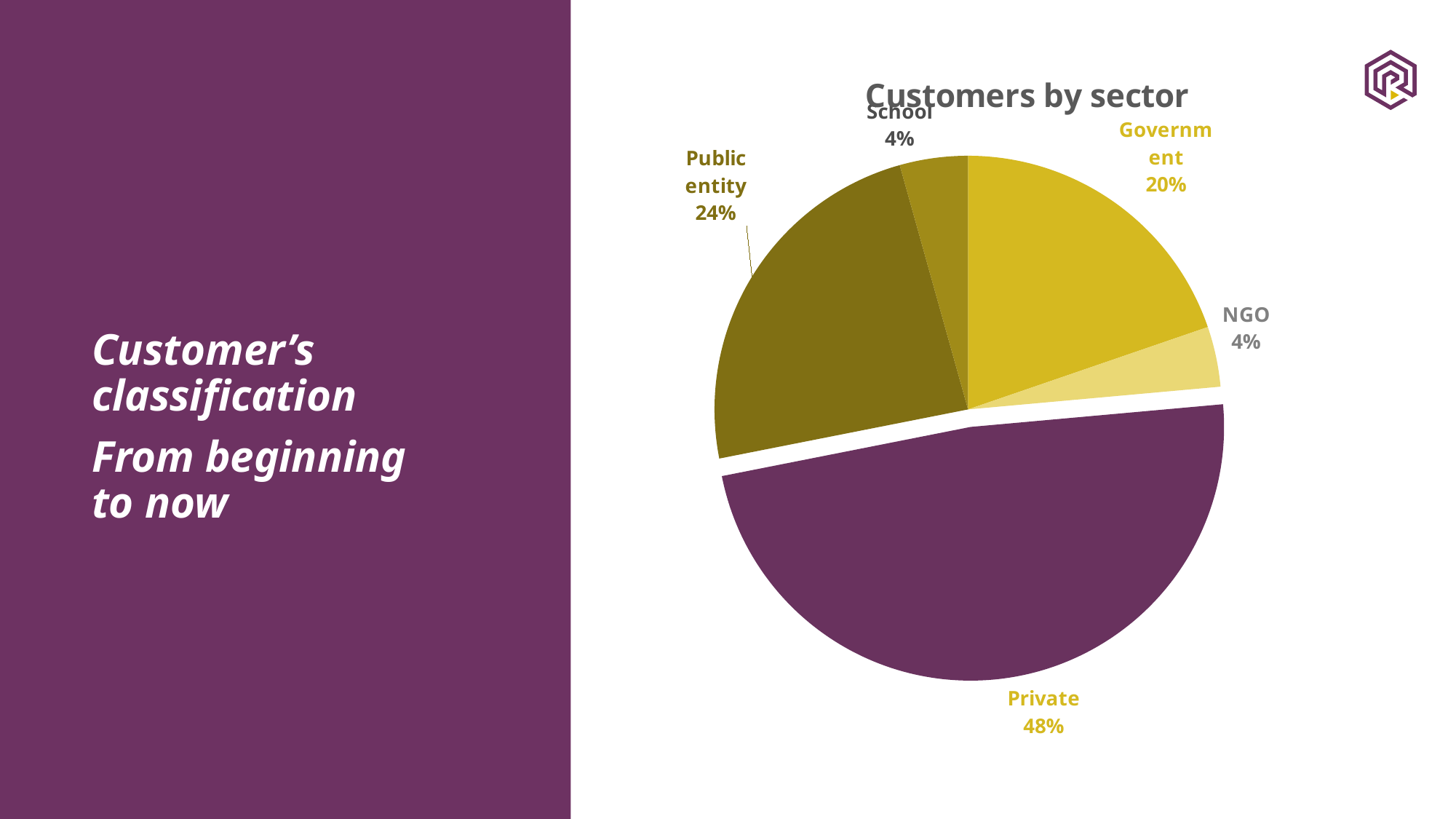
What is the difference in percentage points between the Private and Public entity shares? 24 Which sector has the largest share of customers? Private Which is larger, the Government share or the Public entity share? Public entity Which sector has the largest share among the non-Private sectors? Public entity What percentage of customers are Public entity? 24% What share of customers is in the Private sector? 48% What is the difference in percentage points between Government and School? 16 What is the title of the chart? Customers by sector What type of chart is shown on the slide? Pie chart What percentage of customers are NGOs? 4% How many sectors are shown in the pie chart? 5 What share does the Government slice represent? 20%